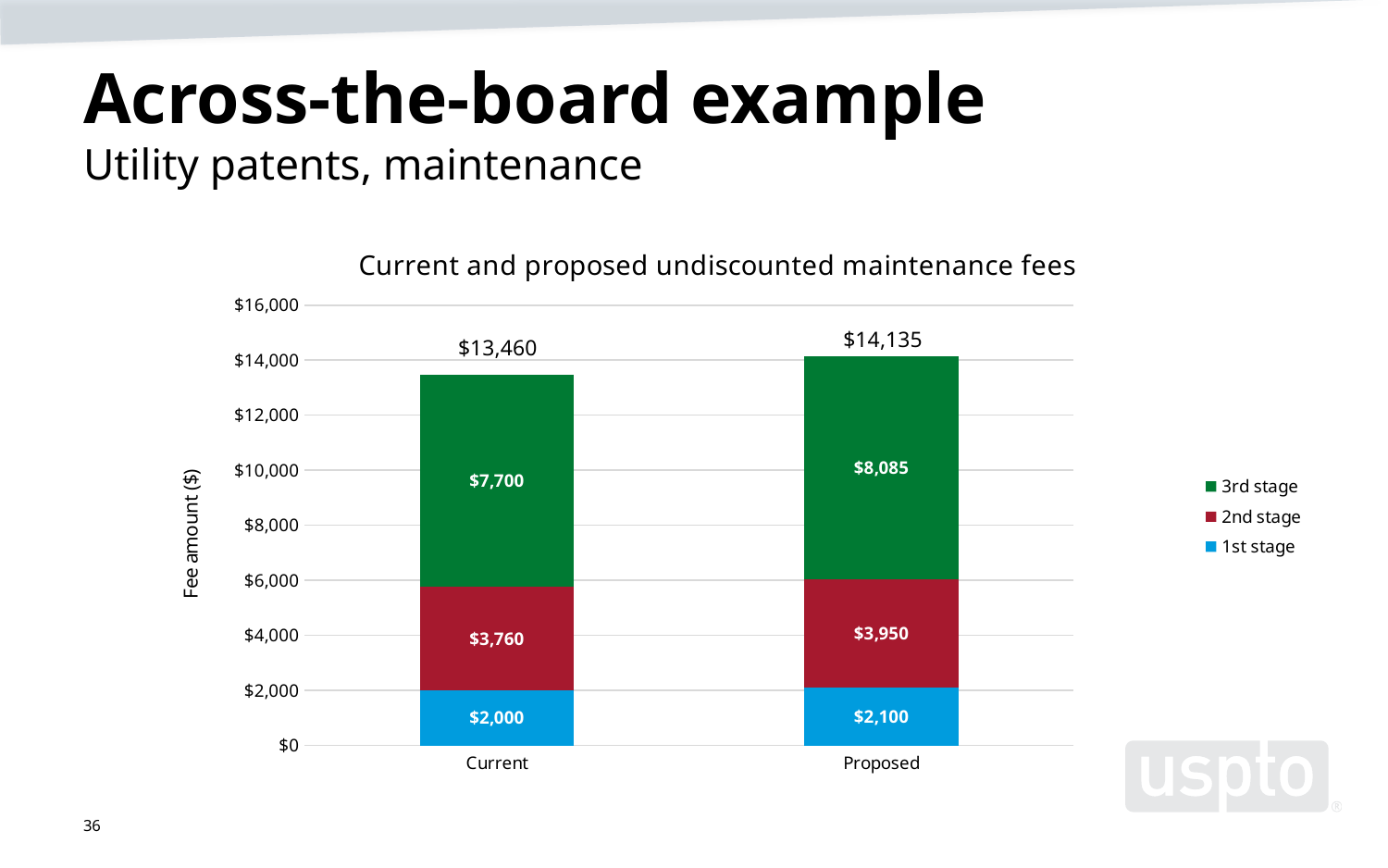
Which stage has the lowest fee in the Proposed bar? 1st stage Which category has the higher total maintenance fee, Current or Proposed? Proposed What is the total of the Current stacked bar? $13,460 What is the difference between the Proposed total and the Current total? $675 What is the 3rd stage fee for the Current category? $7,700 What is the title of the chart? Current and proposed undiscounted maintenance fees What is the total of the Proposed stacked bar? $14,135 What kind of chart is shown on the slide? Stacked bar chart What is the 1st stage fee for the Current category? $2,000 How many series does the legend list? 3 What is the difference between the Proposed and Current 3rd stage fees? $385 What is the 2nd stage fee for the Proposed category? $3,950